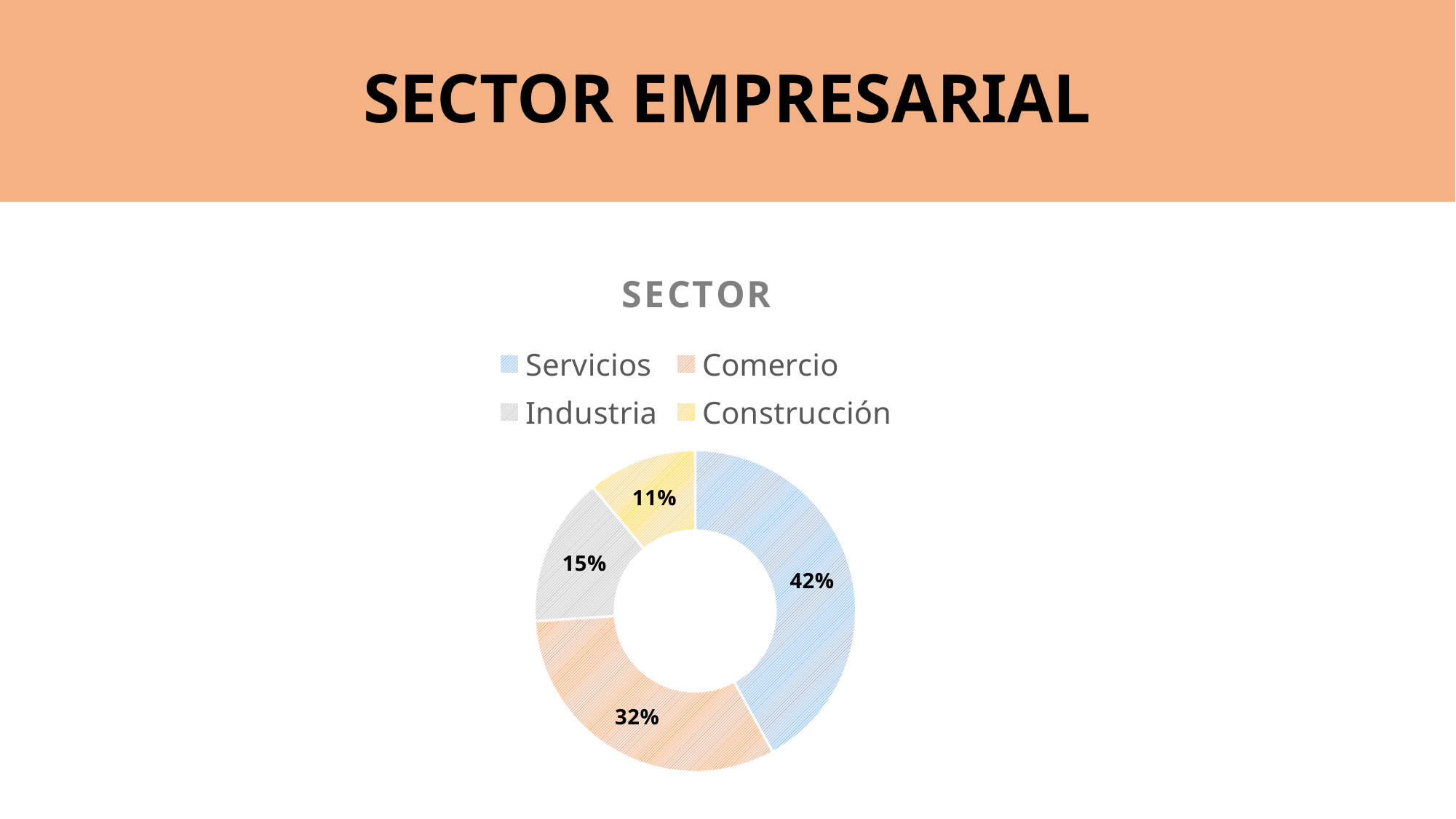
What is the title of the chart on the slide? SECTOR What type of chart is shown on the slide? Doughnut chart What is the difference in percentage points between Servicios and Comercio? 10 What percentage of the SECTOR chart is Servicios? 42% What percentage of the SECTOR chart is Comercio? 32% What is the difference in percentage points between Industria and Construcción? 4 Which has a larger share, Comercio or Industria? Comercio What percentage of the SECTOR chart is Construcción? 11% What percentage of the SECTOR chart is Industria? 15% Which sector has the smallest share in the SECTOR chart? Construcción How many sectors are shown in the SECTOR chart? 4 Which sector has the largest share in the SECTOR chart? Servicios